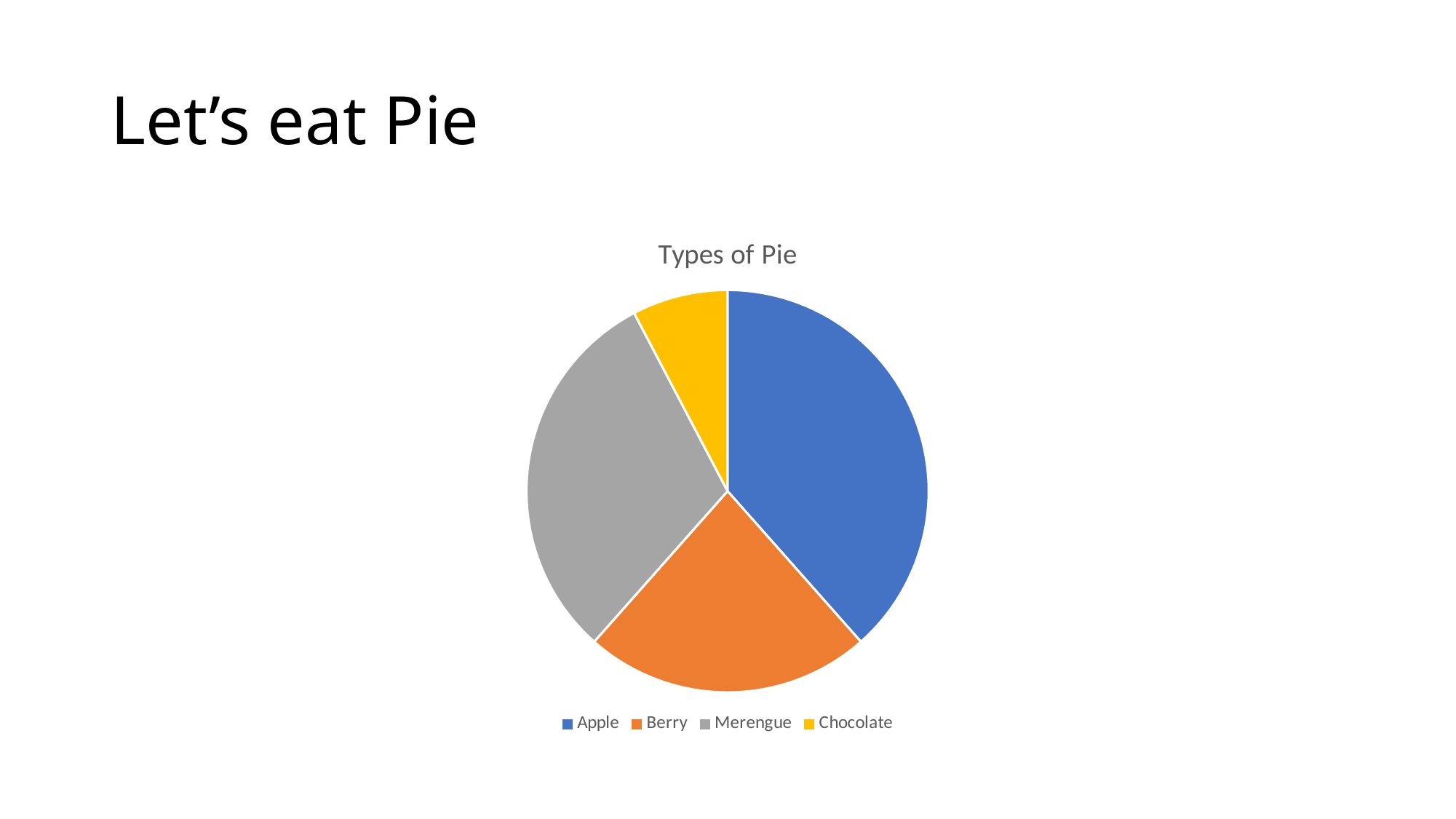
How many entries are listed in the chart's legend? 4 Which slice is larger, Apple or Berry? Apple Which slice is smaller, Berry or Chocolate? Chocolate Which type of pie has the smallest slice? Chocolate What is the title of the chart? Types of Pie Which slice is larger, Merengue or Chocolate? Merengue What kind of chart is shown on the slide? pie chart How many slices does the pie chart have? 4 What colour is the Chocolate slice in the pie chart? yellow Which type of pie has the largest slice? Apple